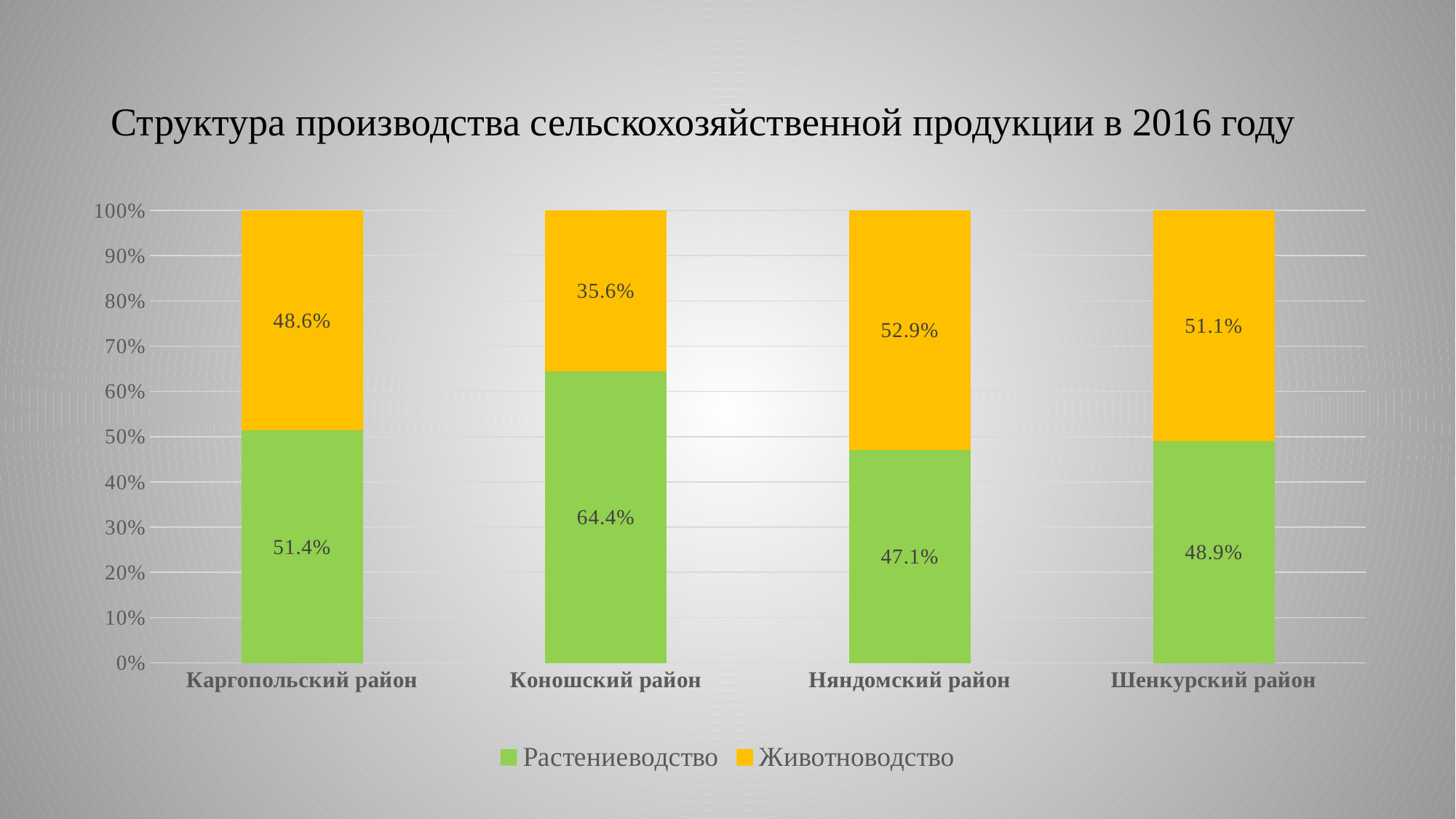
Which district has the lowest value for Животноводство? Коношский район How many series does the legend list? 2 What is the title of the chart? Структура производства сельскохозяйственной продукции в 2016 году Which district has the highest value for Растениеводство? Коношский район What kind of chart is shown on the slide? Stacked bar chart How many districts are shown on the x axis? 4 What is the value for Животноводство in Каргопольский район? 48.6% What is the value for Растениеводство in Коношский район? 64.4% What is the value for Растениеводство in Шенкурский район? 48.9% What is the value for Животноводство in Няндомский район? 52.9% Which is larger: Животноводство in Няндомский район or Животноводство in Шенкурский район? Няндомский район What is the difference between the Растениеводство values for Коношский район and Няндомский район? 17.3%